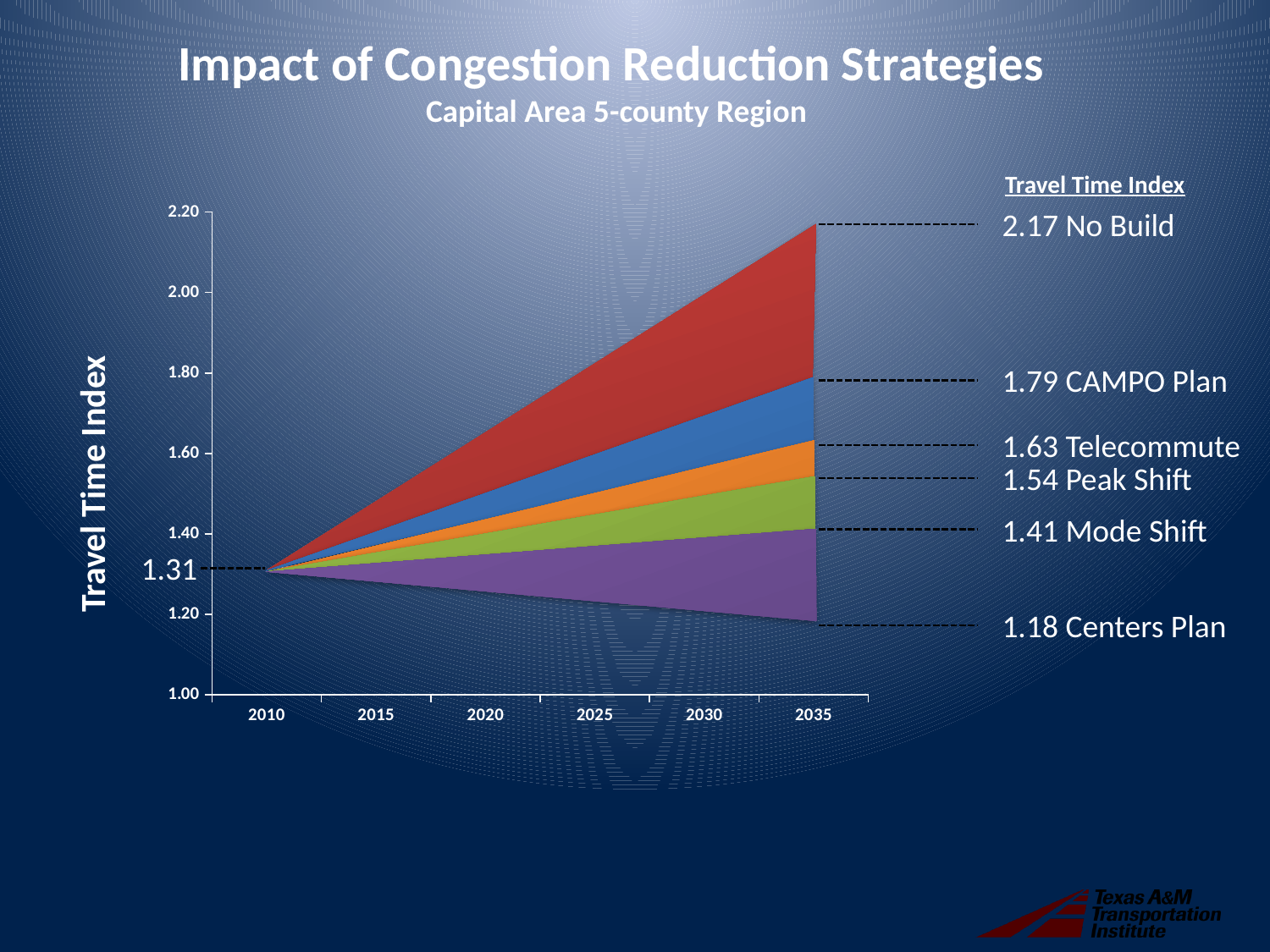
How many scenarios are labelled with a 2035 Travel Time Index on the chart? 6 What is the Travel Time Index for the CAMPO Plan in 2035? 1.79 Which scenario has the highest Travel Time Index in 2035? No Build What is the difference between the 2035 Travel Time Index for No Build and for the CAMPO Plan? 0.38 What is the Travel Time Index value shown for 2010? 1.31 Does the Travel Time Index for the Centers Plan rise or fall from 2010 to 2035? fall Which has a higher Travel Time Index in 2035, Mode Shift or Peak Shift? Peak Shift What is the label on the vertical axis of the chart? Travel Time Index What is the Travel Time Index for the No Build scenario in 2035? 2.17 Which scenario has the lowest Travel Time Index in 2035? Centers Plan What is the difference between the 2035 Travel Time Index for Telecommute and for Peak Shift? 0.09 What is the Travel Time Index for the Centers Plan in 2035? 1.18